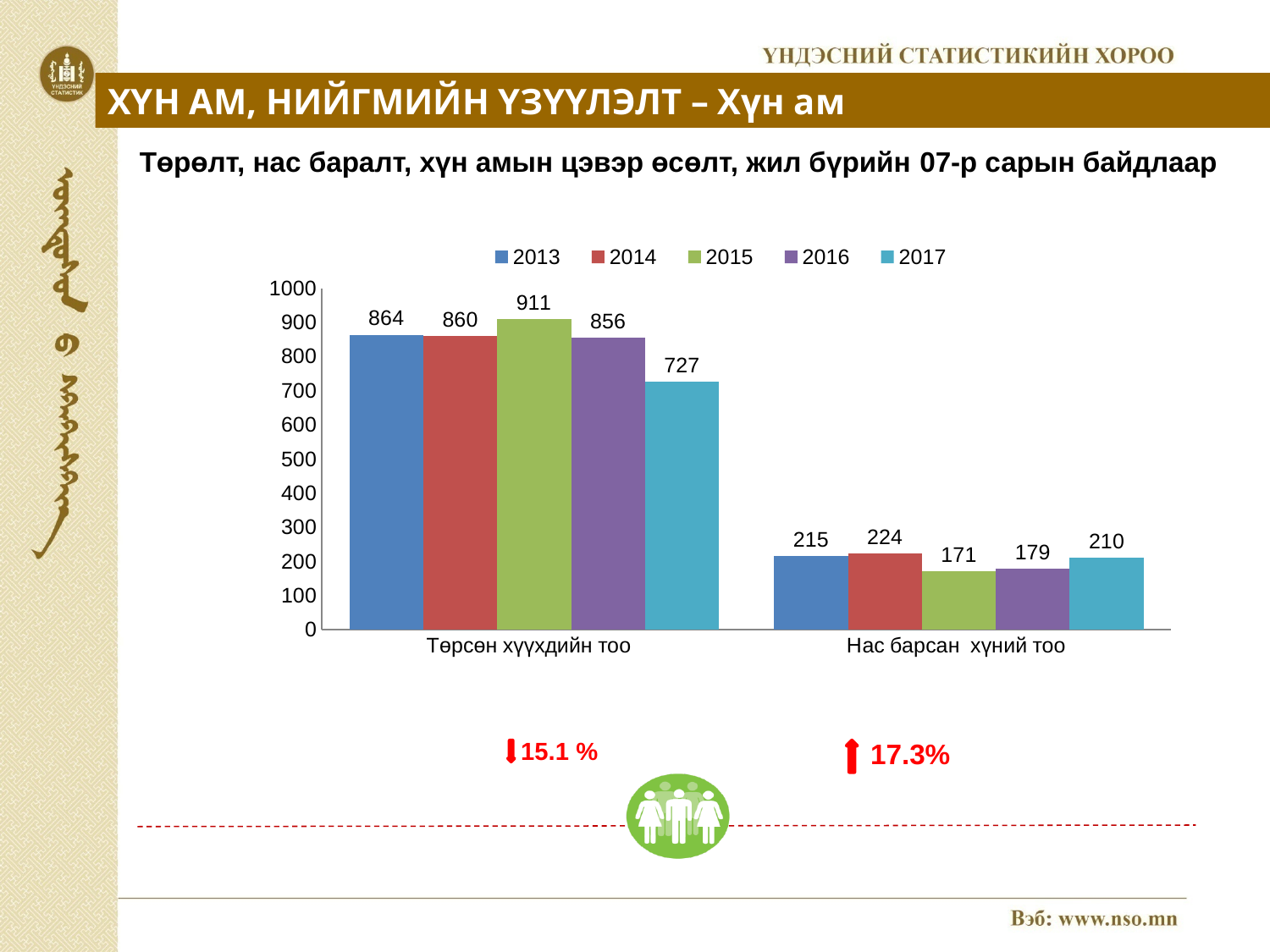
Which colour represents the 2017 series in the legend? Light blue How many categories are shown on the x axis? 2 What is the value for 2013 in the Төрсөн хүүхдийн тоо category? 864 Which is larger in the Нас барсан хүний тоо category: the 2013 value or the 2014 value? 2014 What kind of chart is shown on the slide? Bar chart What is the value for 2017 in the Нас барсан хүний тоо category? 210 Which year has the lowest value in the Нас барсан хүний тоо category? 2015 How many series does the legend list? 5 Which year has the highest value in the Төрсөн хүүхдийн тоо category? 2015 What is the difference between the 2014 and 2015 values in the Нас барсан хүний тоо category? 53 What is the difference between the 2016 and 2017 values in the Төрсөн хүүхдийн тоо category? 129 What is the value for 2015 in the Төрсөн хүүхдийн тоо category? 911